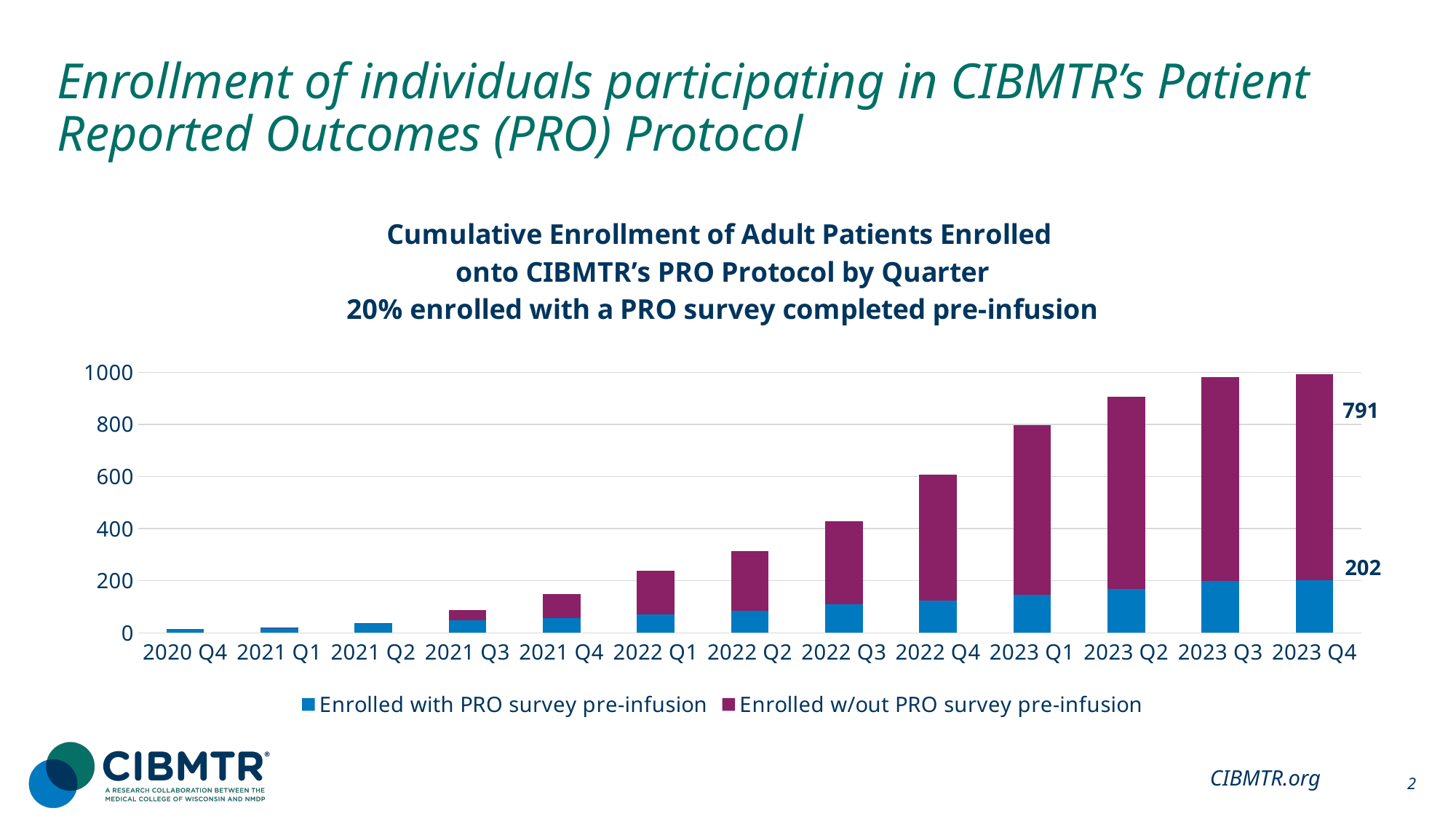
What is the value for 'Enrolled with PRO survey pre-infusion' in 2023 Q4? 202 What kind of chart is shown? Stacked bar chart How many quarters are shown on the x axis? 13 Is the total enrollment for 2022 Q1 greater or less than 400? less What is the difference between the two series values in 2023 Q4? 589 Is the total enrollment for 2022 Q4 greater or less than 400? greater Which quarter has the lowest total enrollment? 2020 Q4 Which quarter has the highest total enrollment? 2023 Q4 What is the value for 'Enrolled w/out PRO survey pre-infusion' in 2023 Q4? 791 How many series does the legend list? 2 Which series has the larger value in 2023 Q4? Enrolled w/out PRO survey pre-infusion What is the total of the stacked bar for 2023 Q4? 993